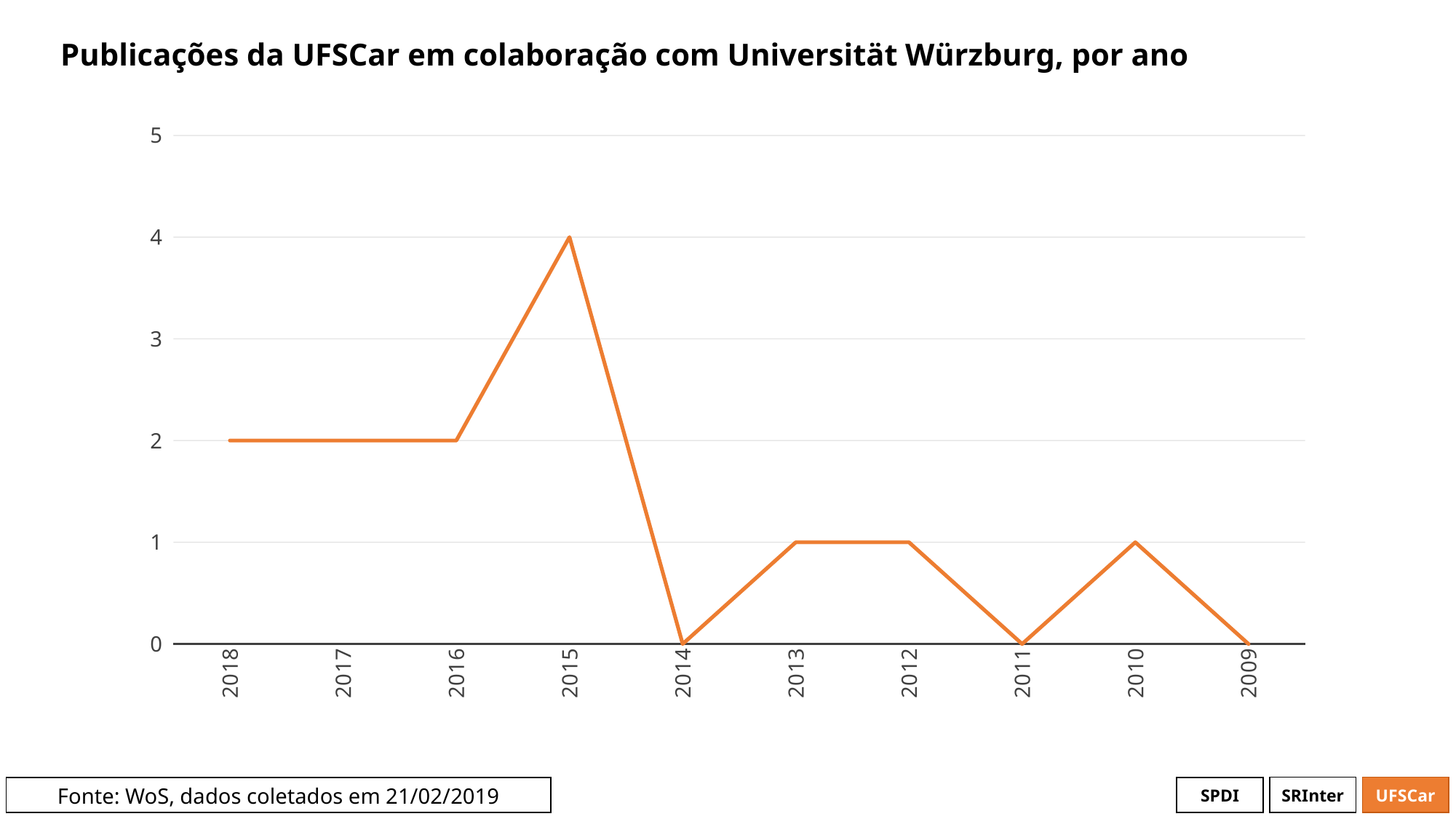
What is the value for 2018? 2 How many years are shown on the x axis? 10 Is the value for 2015 greater or less than 3? greater What is the value for 2015? 4 Which is larger, the value for 2013 or the value for 2017? 2017 Which year has the highest value? 2015 What is the value for 2014? 0 How many years have a value of 0? 3 What is the value for 2010? 1 What type of chart is shown on the slide? line chart What is the title of the chart? Publicações da UFSCar em colaboração com Universität Würzburg, por ano What is the difference between the values for 2015 and 2016? 2